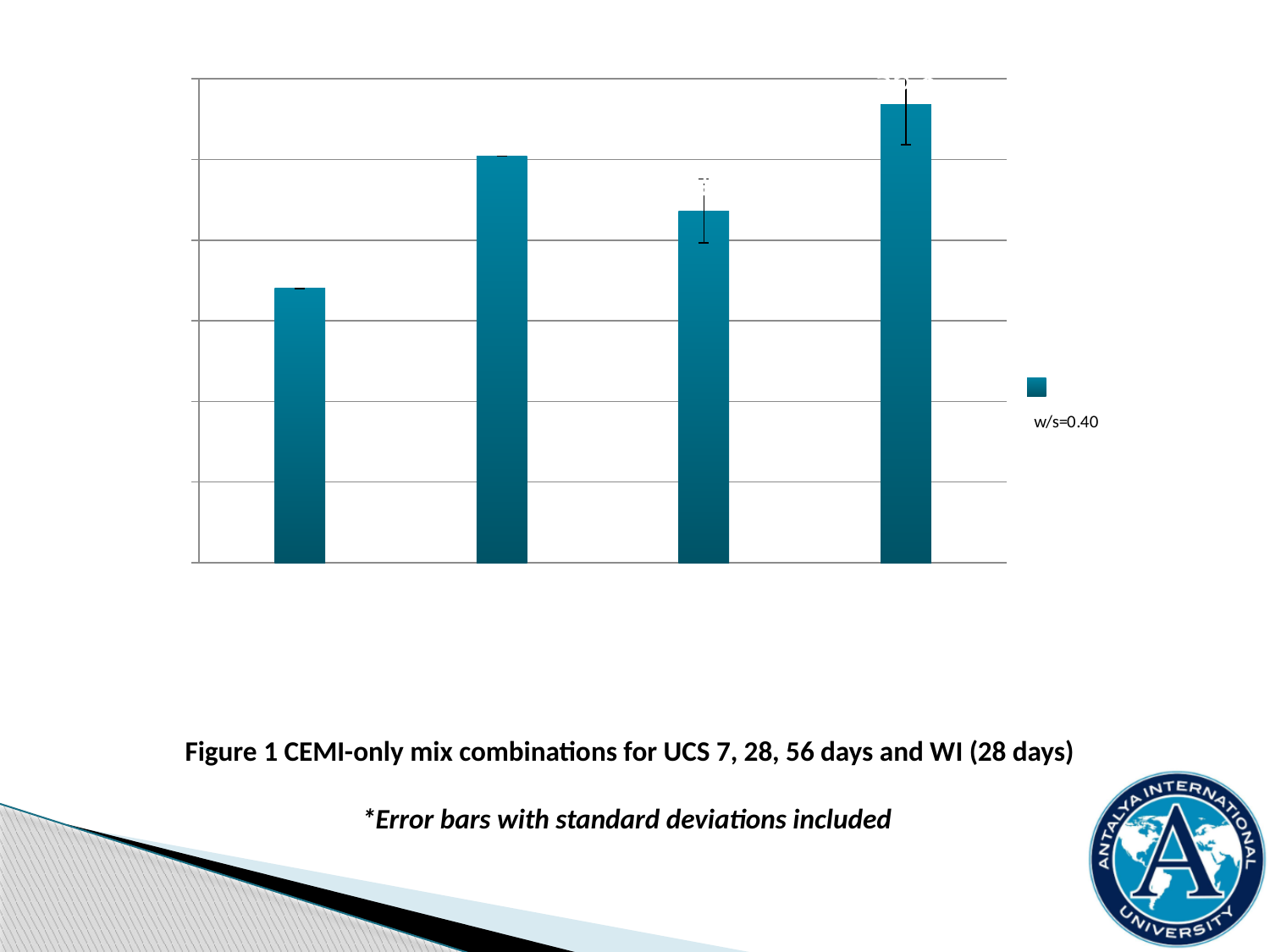
Do the bar heights rise steadily from left to right across the chart? No What kind of chart is shown on the slide? bar chart How many bars are plotted in the chart? 4 How many series does the chart's legend list? 1 Which bar is the tallest in the chart, counting from the left? the fourth (rightmost) bar Which is taller in the chart, the second bar or the third bar from the left? the second bar What is the figure caption given below the chart? Figure 1 CEMI-only mix combinations for UCS 7, 28, 56 days and WI (28 days) Which is taller in the chart, the first bar or the third bar from the left? the third bar Which bar is the shortest in the chart, counting from the left? the first (leftmost) bar